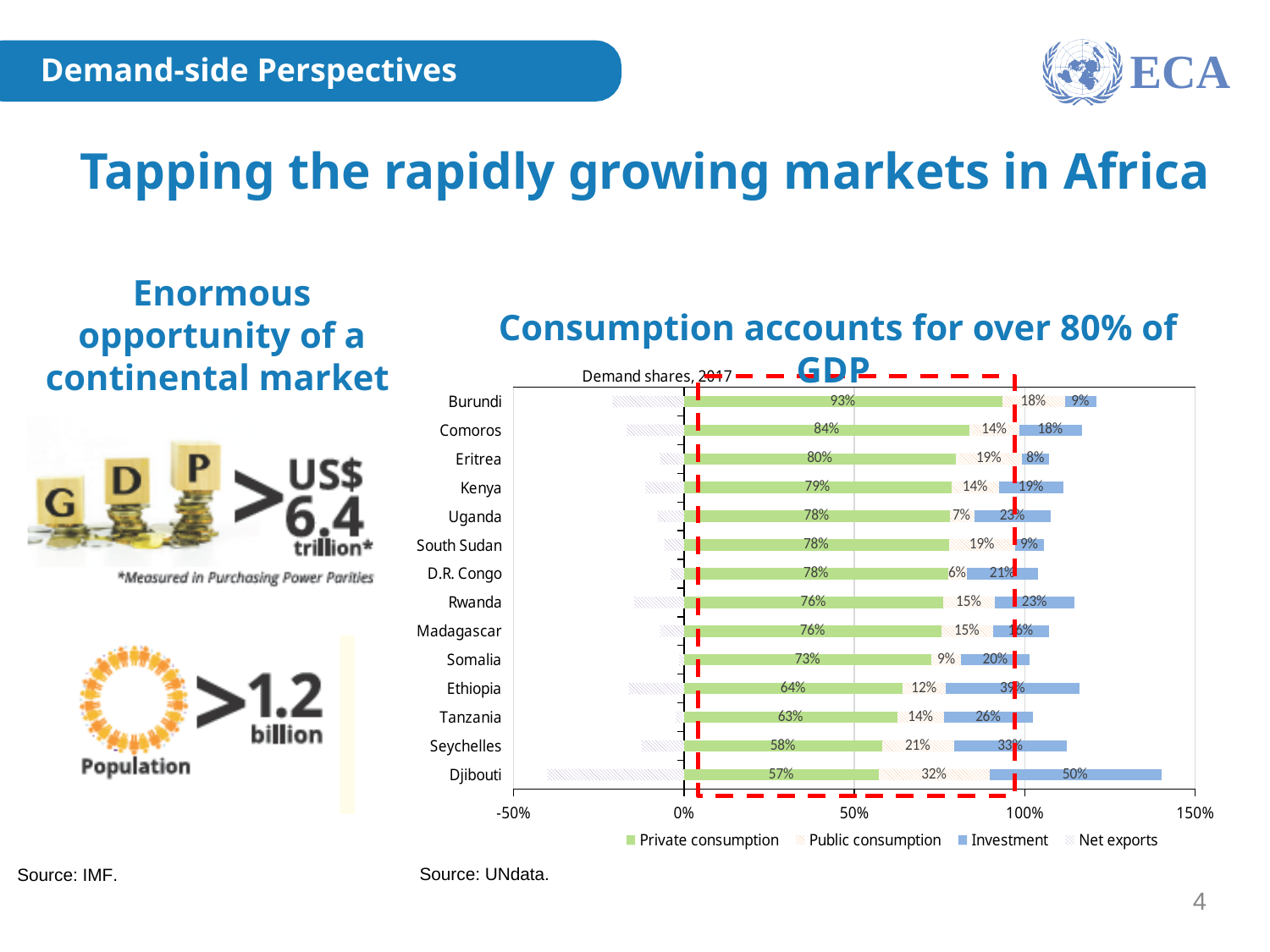
What is the public consumption share for Seychelles? 21% What is the difference in private consumption share between Burundi and Djibouti? 36 percentage points What is the private consumption share for Burundi? 93% Which country has the lowest private consumption share? Djibouti Which country has the highest public consumption share? Djibouti Is the net exports value for Djibouti greater or less than 0%? less What is the investment share for Djibouti? 50% Which country has the highest private consumption share? Burundi What kind of chart is used to show the demand shares? Stacked bar chart How many countries are shown in the chart? 14 How many series does the legend list? 4 Which has a larger private consumption share, Kenya or Tanzania? Kenya